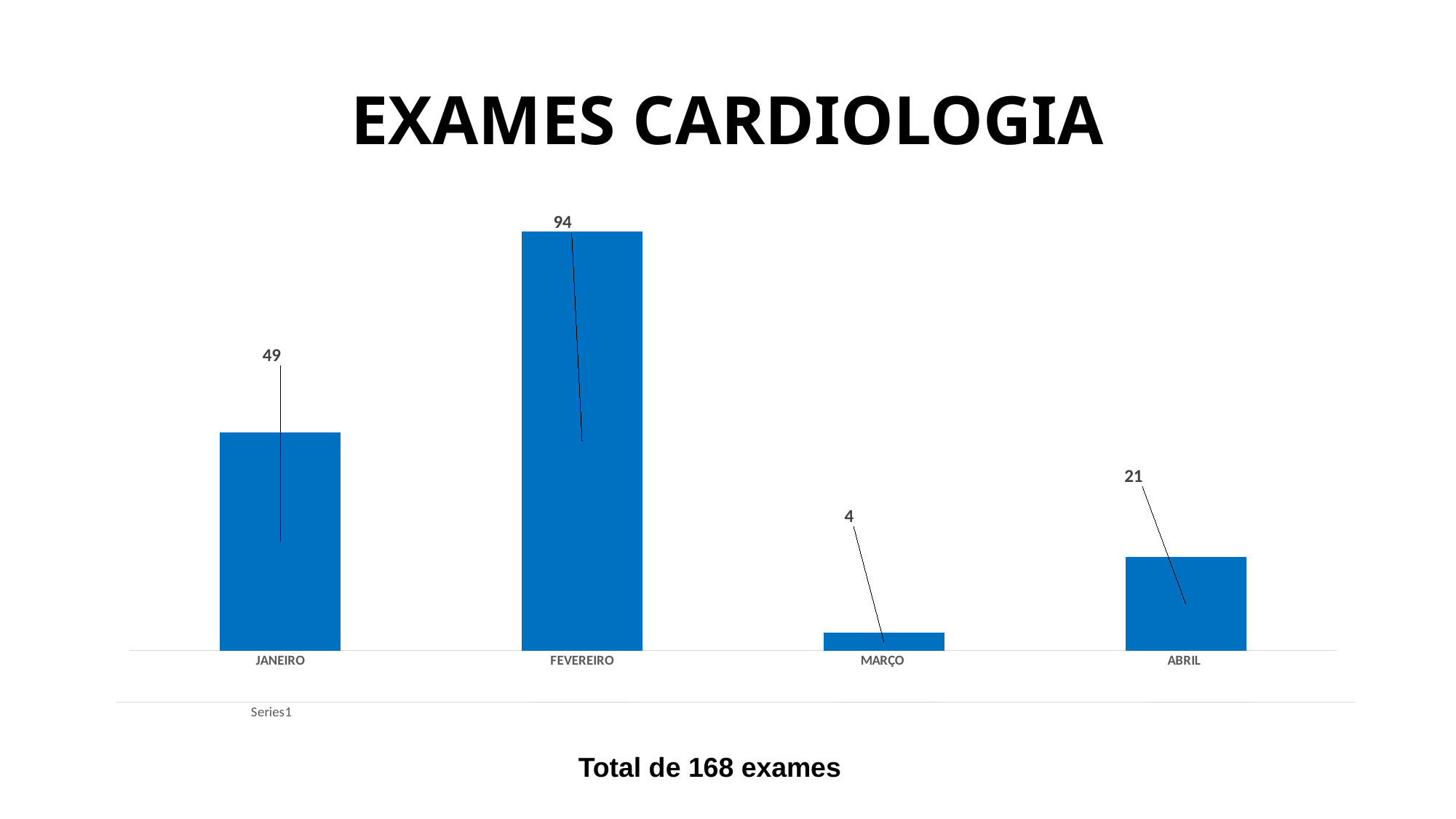
What is the difference between the values for FEVEREIRO and JANEIRO? 45 What is the value for FEVEREIRO? 94 What is the value for JANEIRO? 49 Which is larger, the value for JANEIRO or the value for ABRIL? JANEIRO What is the value for ABRIL? 21 How many months are shown on the x axis? 4 What kind of chart is shown on the slide? Bar chart Which month has the highest value? FEVEREIRO What is the difference between the values for ABRIL and MARÇO? 17 Which month has the lowest value? MARÇO What is the title of the chart? EXAMES CARDIOLOGIA What is the value for MARÇO? 4